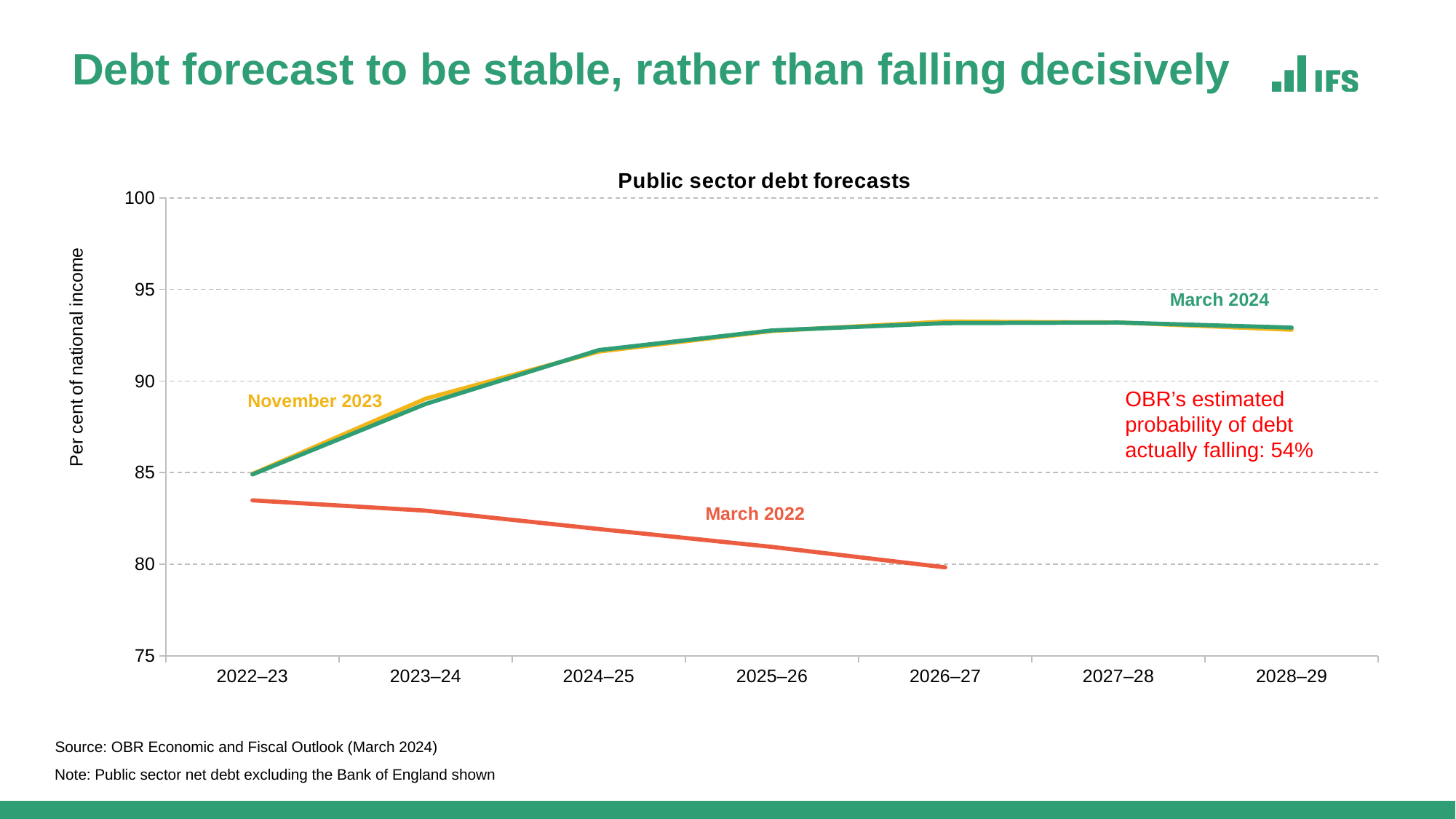
In 2024–25, which forecast is higher: March 2022 or March 2024? March 2024 Is the March 2024 forecast value for 2022–23 greater or less than 80? greater What is the label on the vertical axis of the chart? Per cent of national income Does the March 2022 forecast line rise or fall from 2022–23 to 2026–27? Fall What is the title of the chart? Public sector debt forecasts How many fiscal years are shown on the x axis? 7 How many forecast series are plotted on the chart? 3 Is the March 2022 forecast value for 2026–27 greater or less than 85? less Does the March 2024 forecast line rise or fall between 2022–23 and 2024–25? Rise What kind of chart is shown on the slide? Line chart Is the March 2024 forecast value for 2028–29 greater or less than 90? greater Which forecast series has the lowest values across the years it covers? March 2022